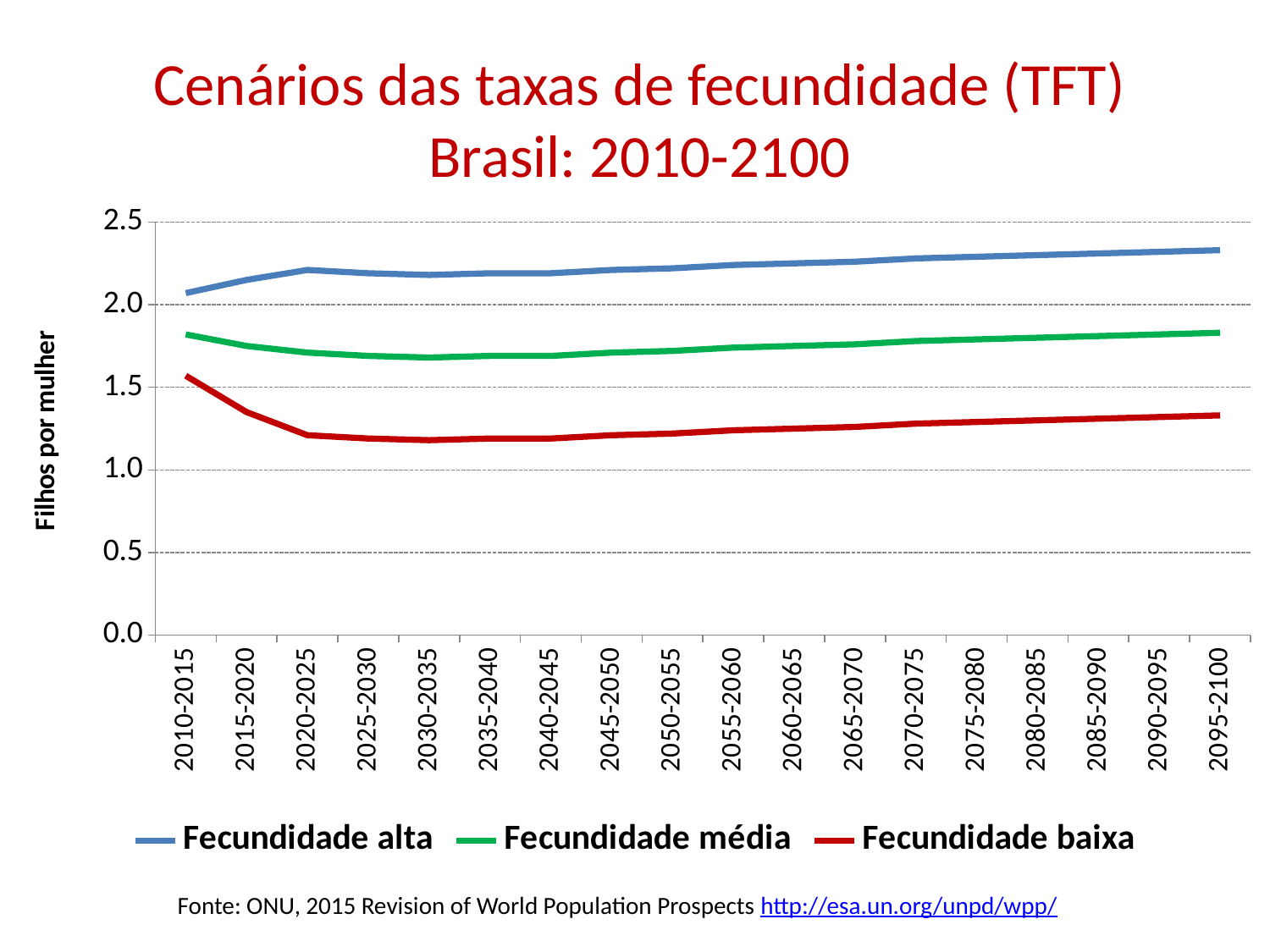
Is the value for Fecundidade baixa in 2030-2035 greater or less than 1.5? less Does the Fecundidade baixa line rise or fall from 2010-2015 to 2020-2025? fall Which series has the highest values across the whole chart? Fecundidade alta Is the value for Fecundidade média in 2010-2015 greater or less than 2.0? less Is the value for Fecundidade alta in 2095-2100 greater or less than 2.0? greater Which series has the lowest values across the whole chart? Fecundidade baixa In 2095-2100, which is larger: Fecundidade alta or Fecundidade baixa? Fecundidade alta How many periods are shown on the x axis? 18 Does the Fecundidade alta line rise or fall from 2030-2035 to 2095-2100? rise How many series does the legend list? 3 What kind of chart is shown on the slide? line chart What is the label of the y axis? Filhos por mulher